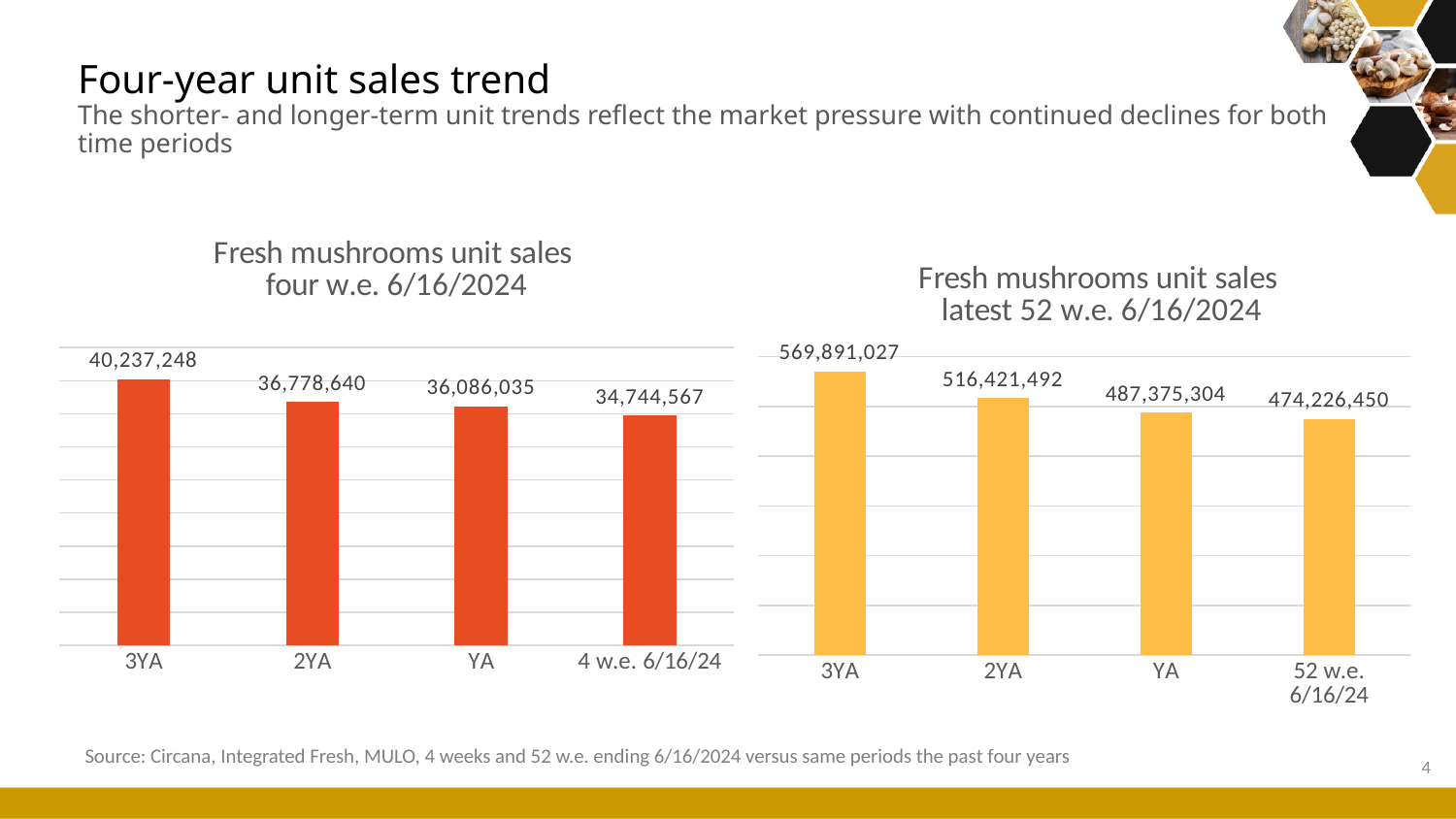
In the 'Fresh mushrooms unit sales four w.e. 6/16/2024' chart, which is larger, the value for 2YA or the value for YA? 2YA In the 'Fresh mushrooms unit sales four w.e. 6/16/2024' chart, what is the difference between the 3YA value and the 4 w.e. 6/16/24 value? 5,492,681 In the 'Fresh mushrooms unit sales four w.e. 6/16/2024' chart, which category has the highest value? 3YA In the 'Fresh mushrooms unit sales latest 52 w.e. 6/16/2024' chart, which category has the lowest value? 52 w.e. 6/16/24 In the 'Fresh mushrooms unit sales latest 52 w.e. 6/16/2024' chart, what is the value for 2YA? 516,421,492 What kind of chart is the 'Fresh mushrooms unit sales four w.e. 6/16/2024' chart? Bar chart In the 'Fresh mushrooms unit sales latest 52 w.e. 6/16/2024' chart, what is the value for 52 w.e. 6/16/24? 474,226,450 In the 'Fresh mushrooms unit sales four w.e. 6/16/2024' chart, what is the value for 3YA? 40,237,248 In the 'Fresh mushrooms unit sales latest 52 w.e. 6/16/2024' chart, what is the difference between the 3YA value and the 2YA value? 53,469,535 In the 'Fresh mushrooms unit sales four w.e. 6/16/2024' chart, what is the value for 4 w.e. 6/16/24? 34,744,567 How many bars are in the 'Fresh mushrooms unit sales latest 52 w.e. 6/16/2024' chart? 4 In the 'Fresh mushrooms unit sales latest 52 w.e. 6/16/2024' chart, do the values rise or fall from 3YA to 52 w.e. 6/16/24? Fall